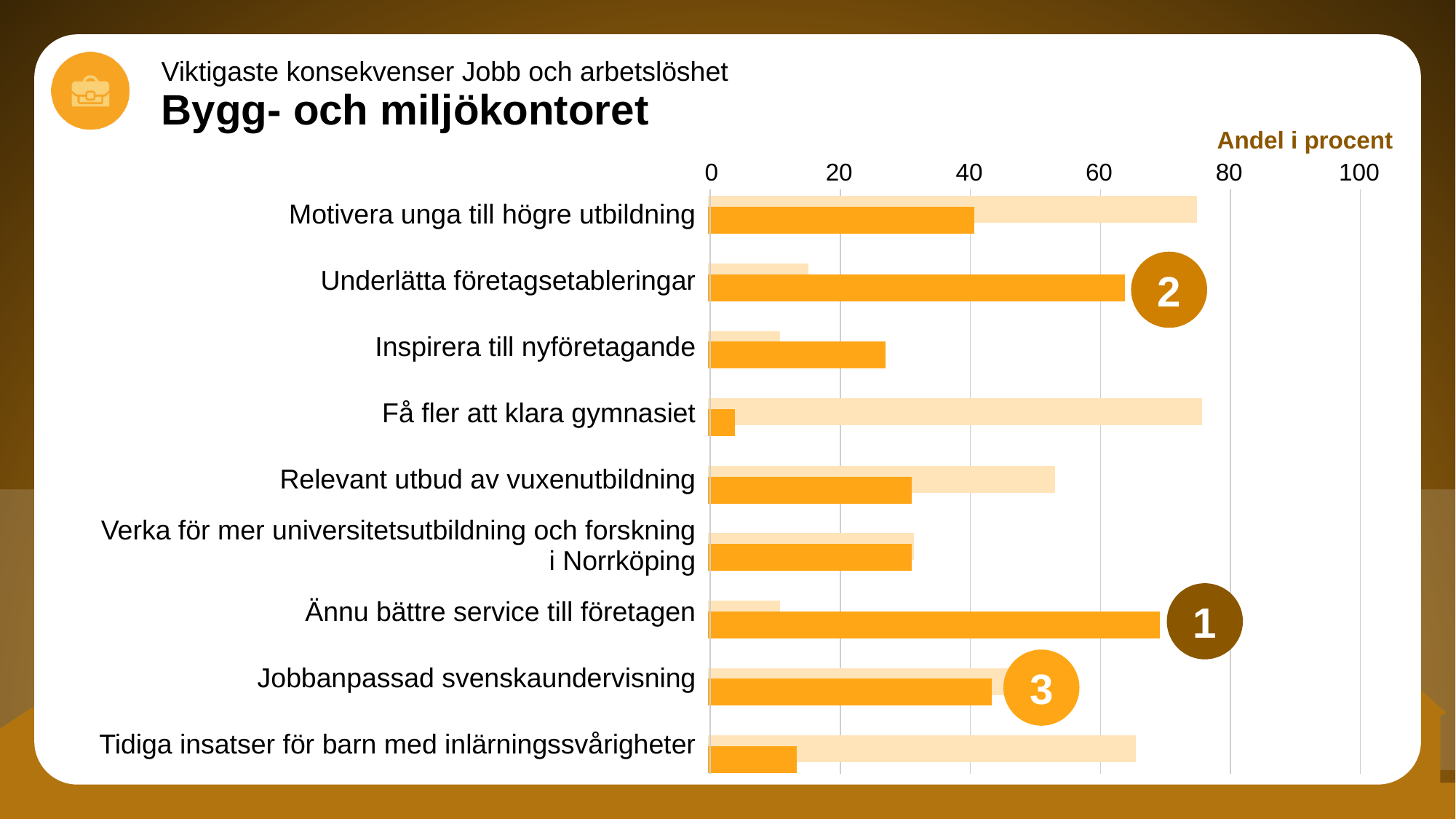
Is the light orange bar for Motivera unga till högre utbildning greater or less than 60? greater Which has the longer dark orange bar: Underlätta företagsetableringar or Inspirera till nyföretagande? Underlätta företagsetableringar Which category has the shortest dark orange bar? Få fler att klara gymnasiet Is the dark orange bar for Tidiga insatser för barn med inlärningssvårigheter greater or less than 20? less Is the light orange bar for Tidiga insatser för barn med inlärningssvårigheter greater or less than 60? greater What is the label shown above the horizontal axis of the chart? Andel i procent What kind of chart is shown on the slide? bar chart How many categories are listed on the chart? 9 Which category has the longest dark orange bar? Ännu bättre service till företagen What number is shown in the circle next to the bar for Ännu bättre service till företagen? 1